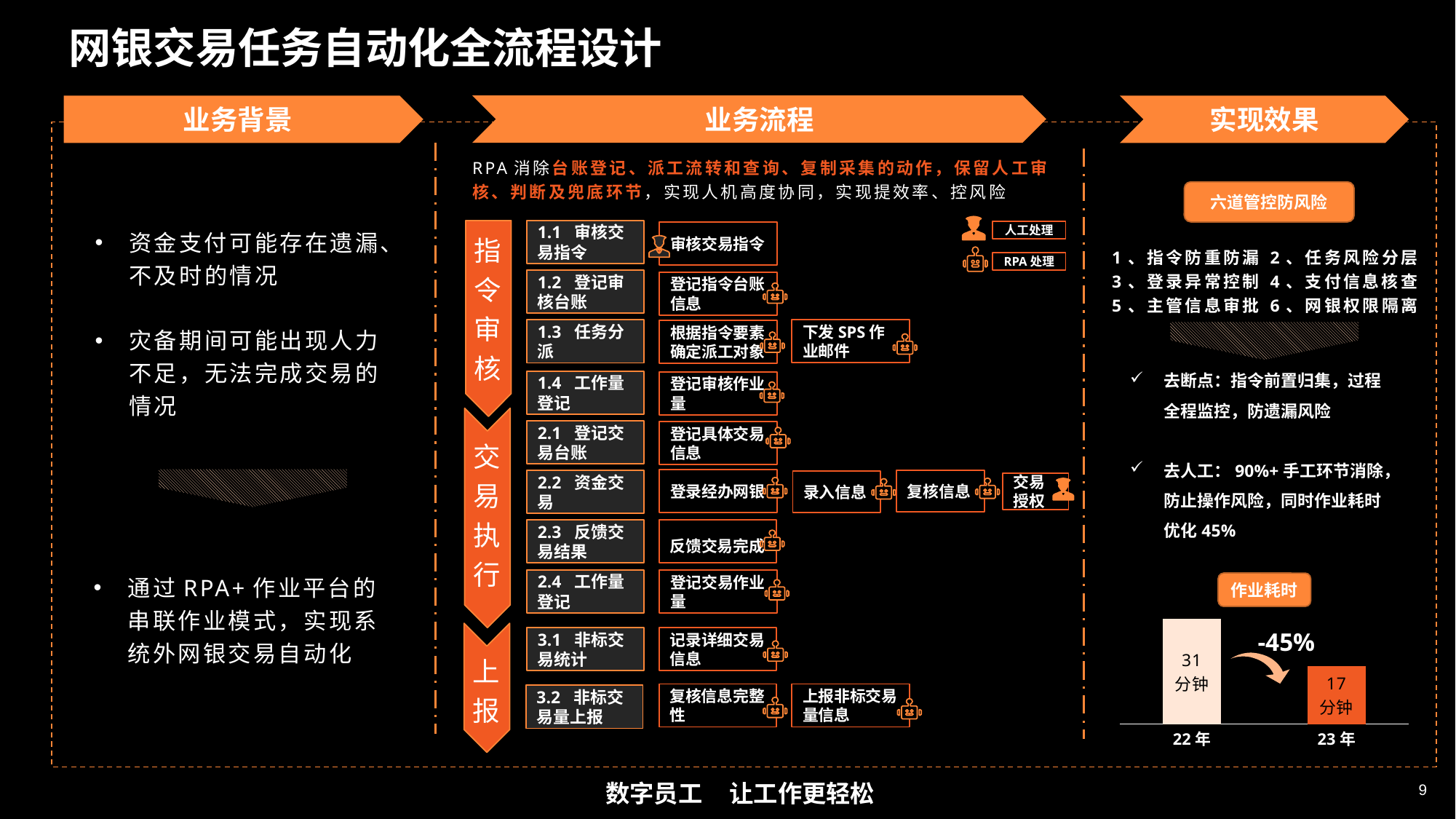
In the 作业耗时 chart, do the values rise or fall from 22 年 to 23 年? fall What is the title of the bar chart on the slide? 作业耗时 In the 作业耗时 chart, is the value for 22 年 larger or smaller than the value for 23 年? larger What kind of chart is the 作业耗时 chart? bar chart What percentage change is annotated on the arrow in the 作业耗时 chart? -45% How many bars are shown in the 作业耗时 chart? 2 In the 作业耗时 chart, what is the value for 23 年? 17 分钟 In the 作业耗时 chart, what is the value for 22 年? 31 分钟 In the 作业耗时 chart, which year has the lower value? 23 年 In the 作业耗时 chart, which year has the higher value? 22 年 In the 作业耗时 chart, what is the difference in minutes between 22 年 and 23 年? 14 分钟